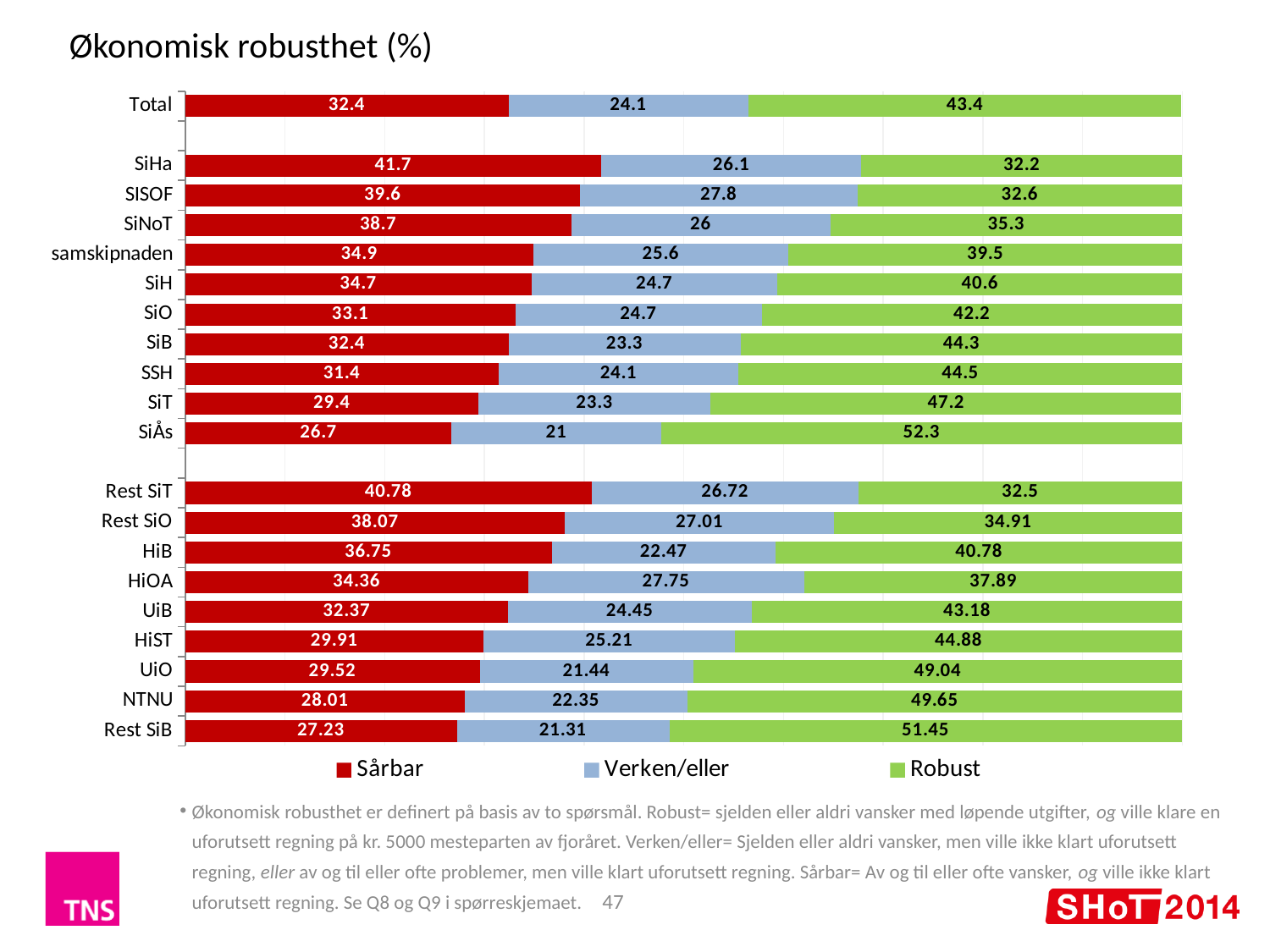
What is the Robust value for SiÅs? 52.3 How many series does the legend list? 3 What is the Verken/eller value for HiOA? 27.75 What is the total of the stacked bar for SiÅs? 100 Which category has the lowest Sårbar value? SiÅs What kind of chart is shown on the slide? Stacked bar chart What is the Sårbar value for SiHa? 41.7 Which category has the highest Sårbar value? SiHa Which has a larger Robust value, SiT or UiO? UiO How many categories are shown on the chart? 20 Which category has the highest Robust value? SiÅs What is the difference between the Robust and Sårbar values for NTNU? 21.64